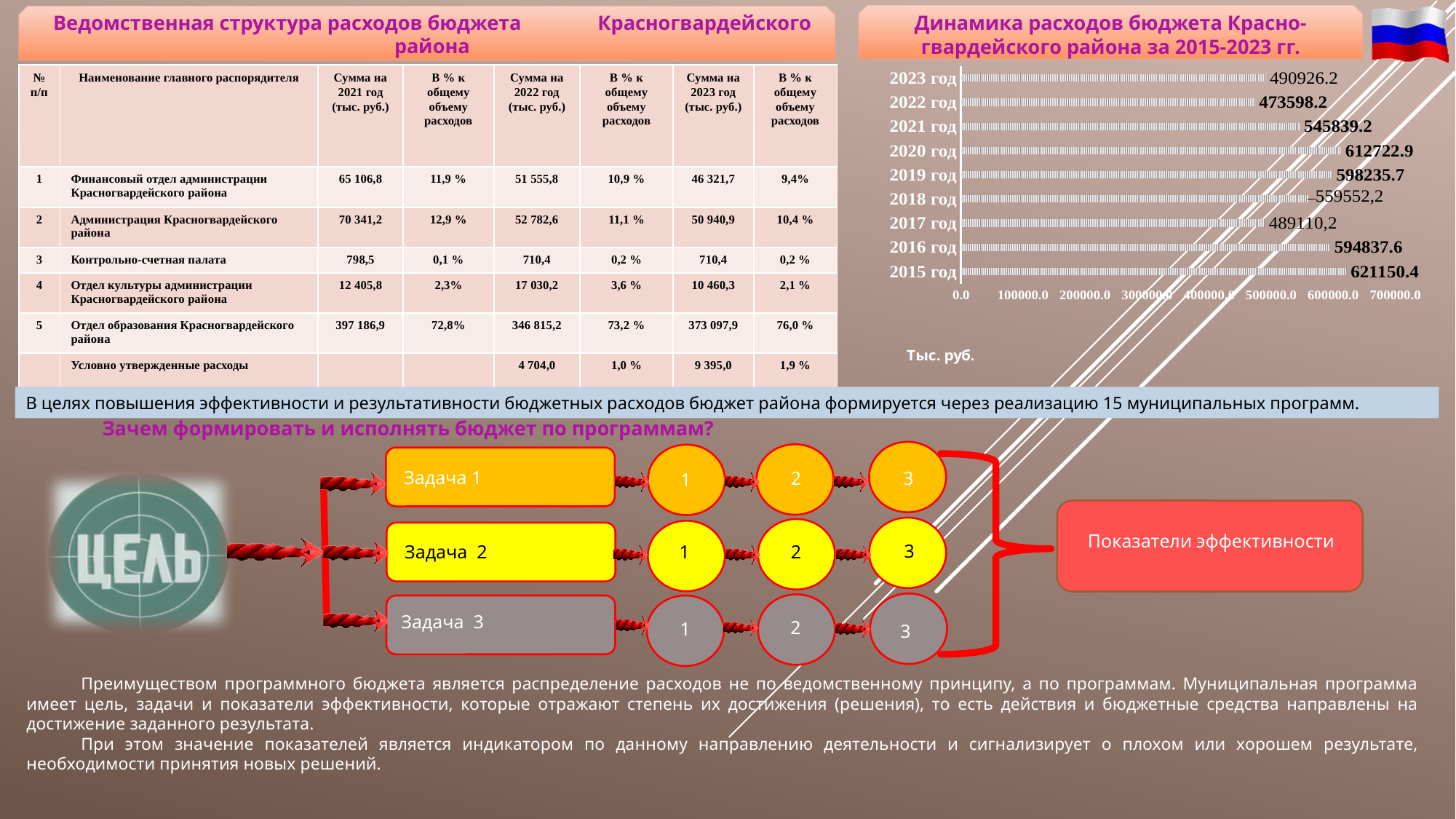
In the chart "Динамика расходов бюджета Красногвардейского района за 2015-2023 гг.", what is the difference between the values for 2015 год and 2020 год? 8427.5 In the chart "Динамика расходов бюджета Красногвардейского района за 2015-2023 гг.", what is the value for 2016 год? 594837.6 In the chart "Динамика расходов бюджета Красногвардейского района за 2015-2023 гг.", which year has the lowest value? 2022 год What unit is indicated below the chart "Динамика расходов бюджета Красногвардейского района за 2015-2023 гг."? Тыс. руб. In the chart "Динамика расходов бюджета Красногвардейского района за 2015-2023 гг.", what is the difference between the values for 2021 год and 2022 год? 72241.0 What type of chart is shown under the title "Динамика расходов бюджета Красногвардейского района за 2015-2023 гг."? bar chart In the chart "Динамика расходов бюджета Красногвардейского района за 2015-2023 гг.", what is the value for 2023 год? 490926.2 How many years are shown in the chart "Динамика расходов бюджета Красногвардейского района за 2015-2023 гг."? 9 In the chart "Динамика расходов бюджета Красногвардейского района за 2015-2023 гг.", what is the value for 2018 год? 559552,2 In the chart "Динамика расходов бюджета Красногвардейского района за 2015-2023 гг.", which year has the highest value? 2015 год In the chart "Динамика расходов бюджета Красногвардейского района за 2015-2023 гг.", which is larger: the value for 2019 год or the value for 2016 год? 2019 год In the chart "Динамика расходов бюджета Красногвардейского района за 2015-2023 гг.", is the value for 2023 год greater or less than 500000.0? less